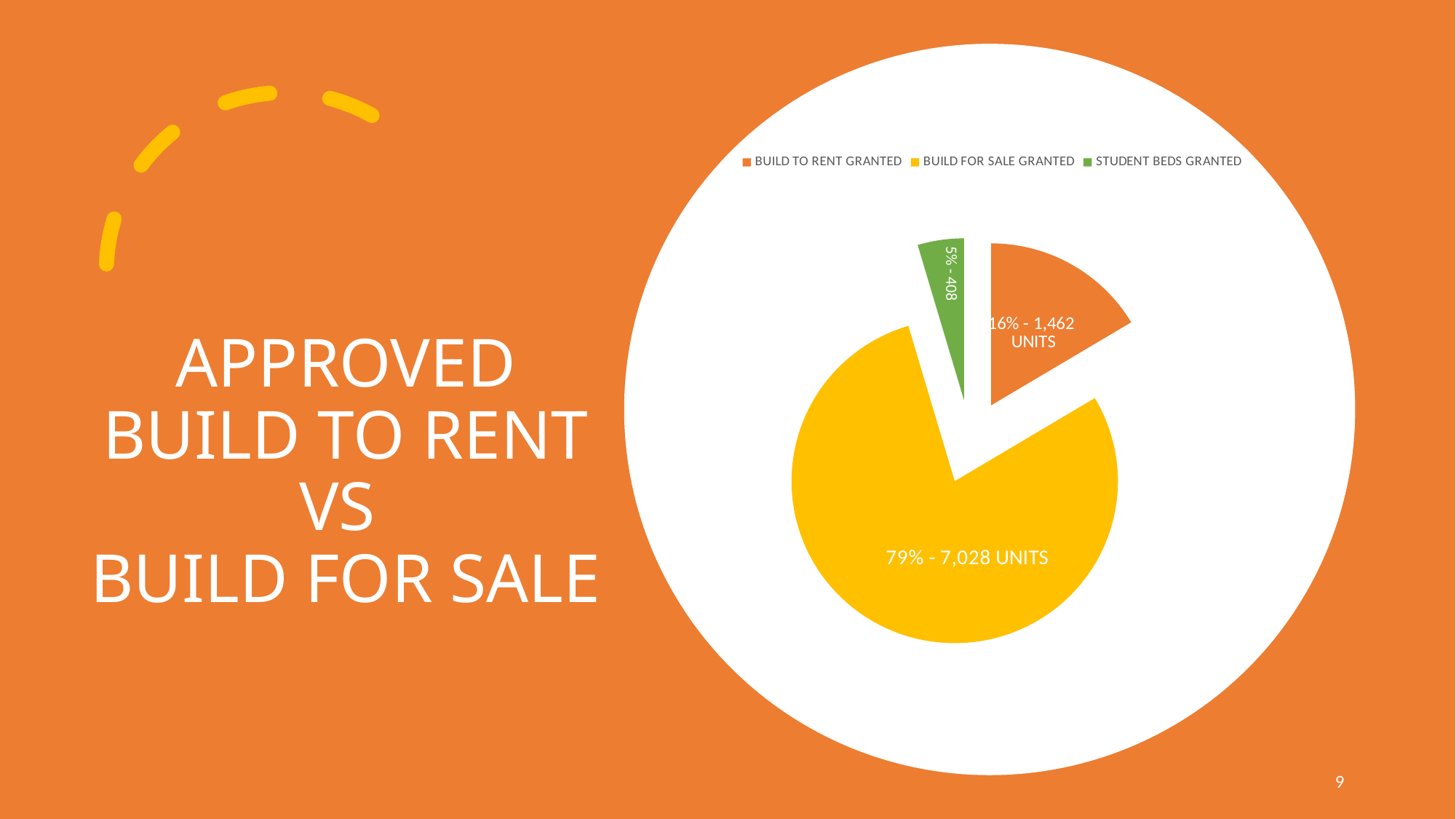
What share of the pie is Build to Rent Granted? 16% How many units were granted for Build to Rent? 1,462 What is the value shown for Student Beds Granted? 408 How many entries does the legend list? 3 What share of the pie is Build for Sale Granted? 79% What share of the pie is Student Beds Granted? 5% What kind of chart is shown on the slide? Pie chart What is the difference in units between Build for Sale Granted and Build to Rent Granted? 5,566 Which category has the largest slice of the pie? Build for Sale Granted How many units were granted for Build for Sale? 7,028 How many slices does the pie chart have? 3 Which category has the smallest slice of the pie? Student Beds Granted